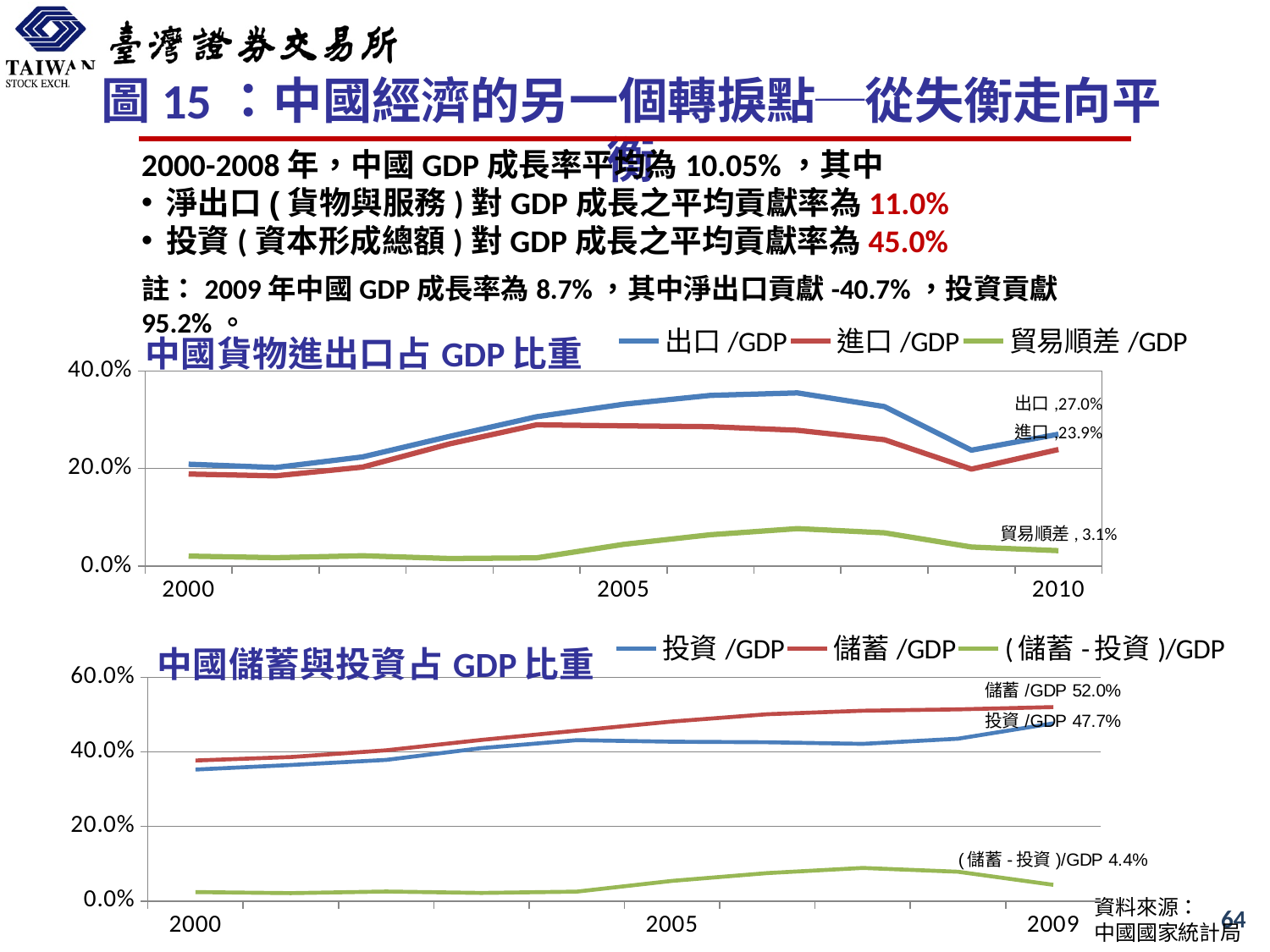
In the top chart (中國貨物進出口占 GDP 比重), is the value of 出口/GDP in 2007 greater or less than 30.0%? greater In the top chart (中國貨物進出口占 GDP 比重), what is the labelled value of 進口/GDP in 2010? 23.9% In the bottom chart (中國儲蓄與投資占 GDP 比重), what is the labelled value of 儲蓄/GDP in 2009? 52.0% What type of chart is the bottom chart (中國儲蓄與投資占 GDP 比重)? line chart In the bottom chart (中國儲蓄與投資占 GDP 比重), what is the labelled value of (儲蓄-投資)/GDP in 2009? 4.4% In the top chart (中國貨物進出口占 GDP 比重), what is the labelled value of 出口/GDP at the end of the series in 2010? 27.0% In the bottom chart (中國儲蓄與投資占 GDP 比重), what is the labelled value of 投資/GDP in 2009? 47.7% In the top chart (中國貨物進出口占 GDP 比重), what is the labelled value of 貿易順差/GDP in 2010? 3.1% In the top chart (中國貨物進出口占 GDP 比重), how many series does the legend list? 3 In the bottom chart (中國儲蓄與投資占 GDP 比重), which is larger in 2009, 儲蓄/GDP or 投資/GDP? 儲蓄/GDP In the bottom chart (中國儲蓄與投資占 GDP 比重), does 儲蓄/GDP generally rise or fall from 2000 to 2009? rise In the top chart (中國貨物進出口占 GDP 比重), what is the difference between the 2010 values of 出口/GDP and 進口/GDP? 3.1%